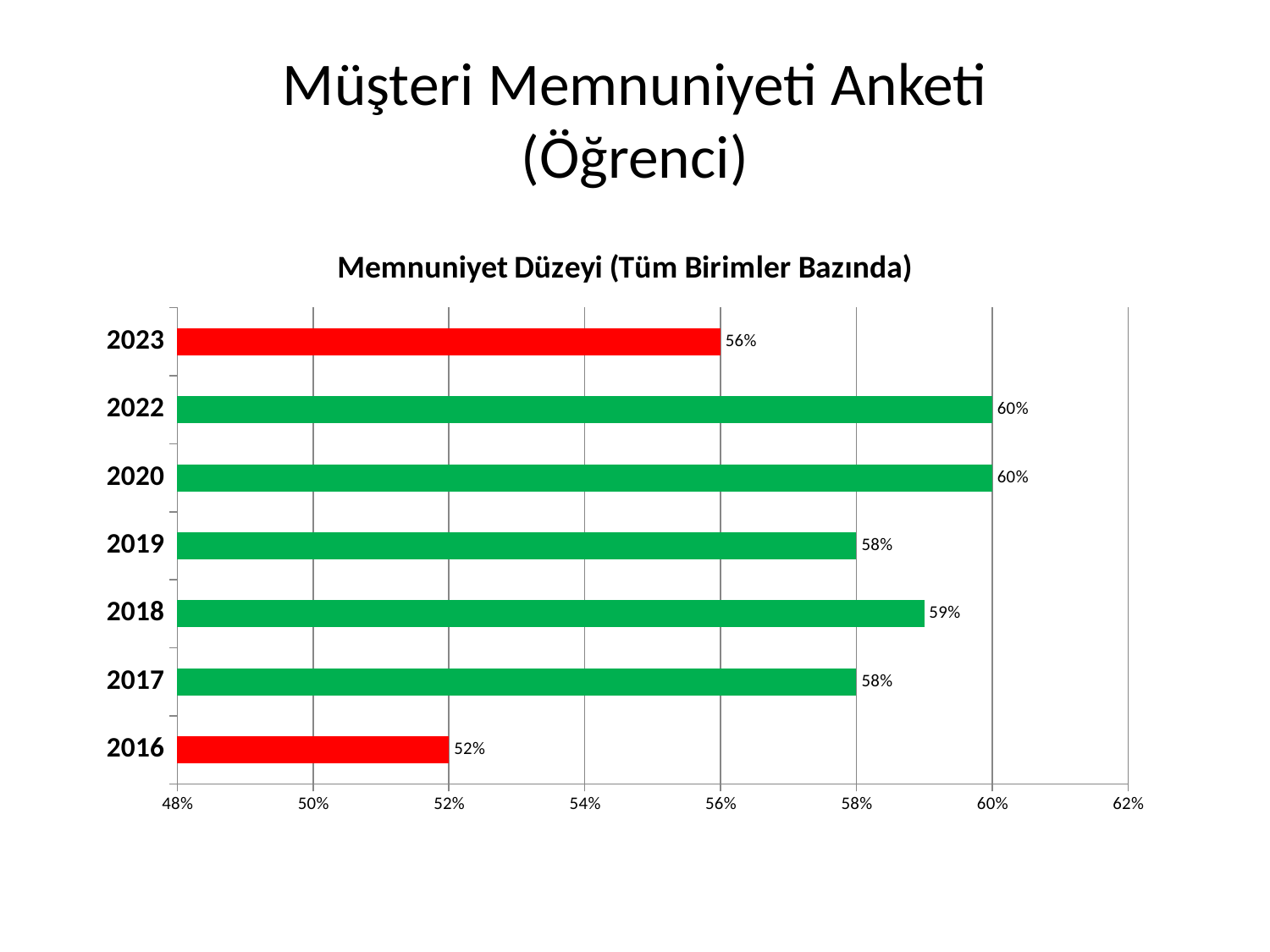
What is the title of the chart? Memnuniyet Düzeyi (Tüm Birimler Bazında) Which years are shown with red bars? 2016 and 2023 How many years are shown on the chart? 7 What is the difference between the satisfaction levels for 2018 and 2016? 7% What is the satisfaction level for 2018? 59% Which year has the lowest satisfaction level? 2016 What is the difference between the satisfaction levels for 2022 and 2023? 4% Which is larger, the value for 2019 or the value for 2018? 2018 What is the satisfaction level for 2023? 56% What is the satisfaction level for 2016? 52% What kind of chart is shown on the slide? bar chart Is the value for 2023 greater or less than 58%? less